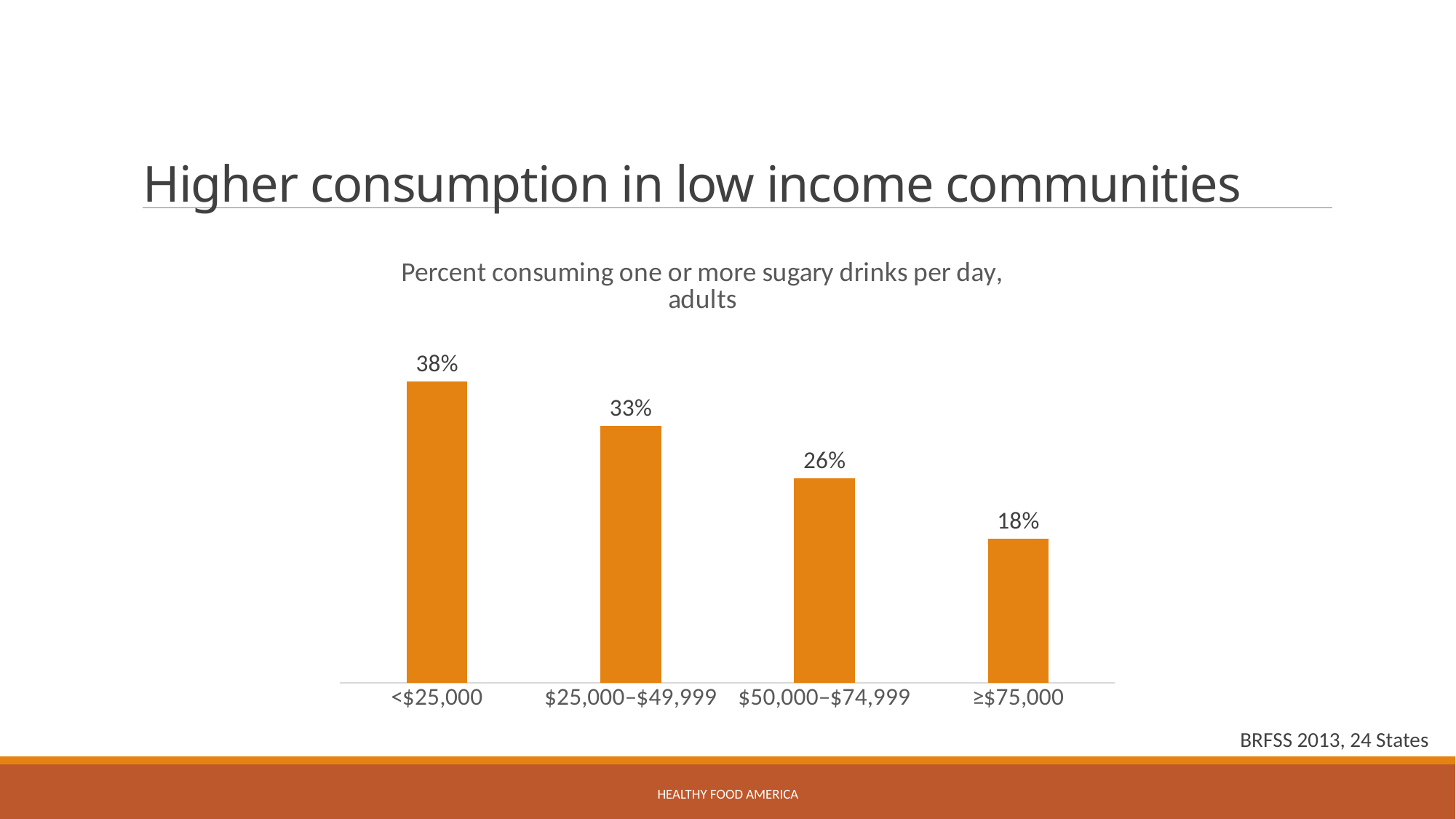
What kind of chart is shown on the slide? Bar chart Which income group has the highest percent consuming one or more sugary drinks per day? <$25,000 What is the value for the $25,000–$49,999 income group? 33% What percent of adults with income <$25,000 consume one or more sugary drinks per day? 38% What is the value for the ≥$75,000 income group? 18% What is the difference between the <$25,000 group and the ≥$75,000 group? 20% What is the difference between the $25,000–$49,999 group and the $50,000–$74,999 group? 7% Which is larger, the value for $25,000–$49,999 or the value for $50,000–$74,999? $25,000–$49,999 How many income groups are shown in the chart? 4 Which income group has the lowest percent consuming one or more sugary drinks per day? ≥$75,000 Do the values rise or fall as income increases along the x axis? Fall What is the value for the $50,000–$74,999 income group? 26%